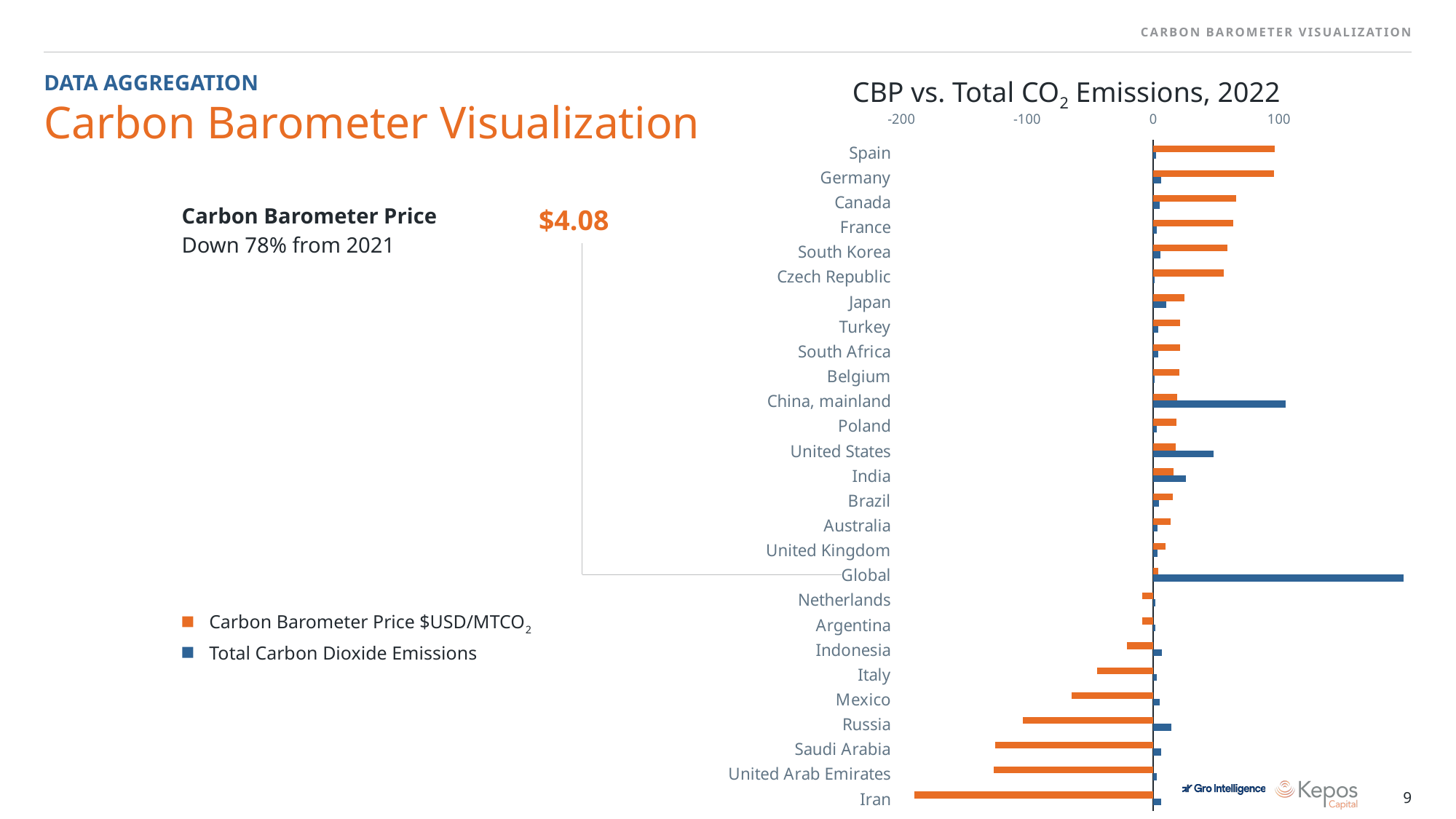
What Carbon Barometer Price is shown for Global in the callout? $4.08 How many series does the legend of the chart list? 2 Which has the more negative Carbon Barometer Price, Saudi Arabia or Italy? Saudi Arabia Which colour represents the Carbon Barometer Price series in the chart? orange How many countries/regions are listed on the chart's category axis? 27 Which has the larger Total Carbon Dioxide Emissions bar, China, mainland or United States? China, mainland Is the Carbon Barometer Price for Iran greater or less than -100? less Which category has the lowest (most negative) Carbon Barometer Price? Iran Is the Total Carbon Dioxide Emissions value for Global greater or less than 100? greater What kind of chart is shown on the slide? bar chart What is the title of the chart? CBP vs. Total CO2 Emissions, 2022 Which category has the largest Total Carbon Dioxide Emissions bar? Global